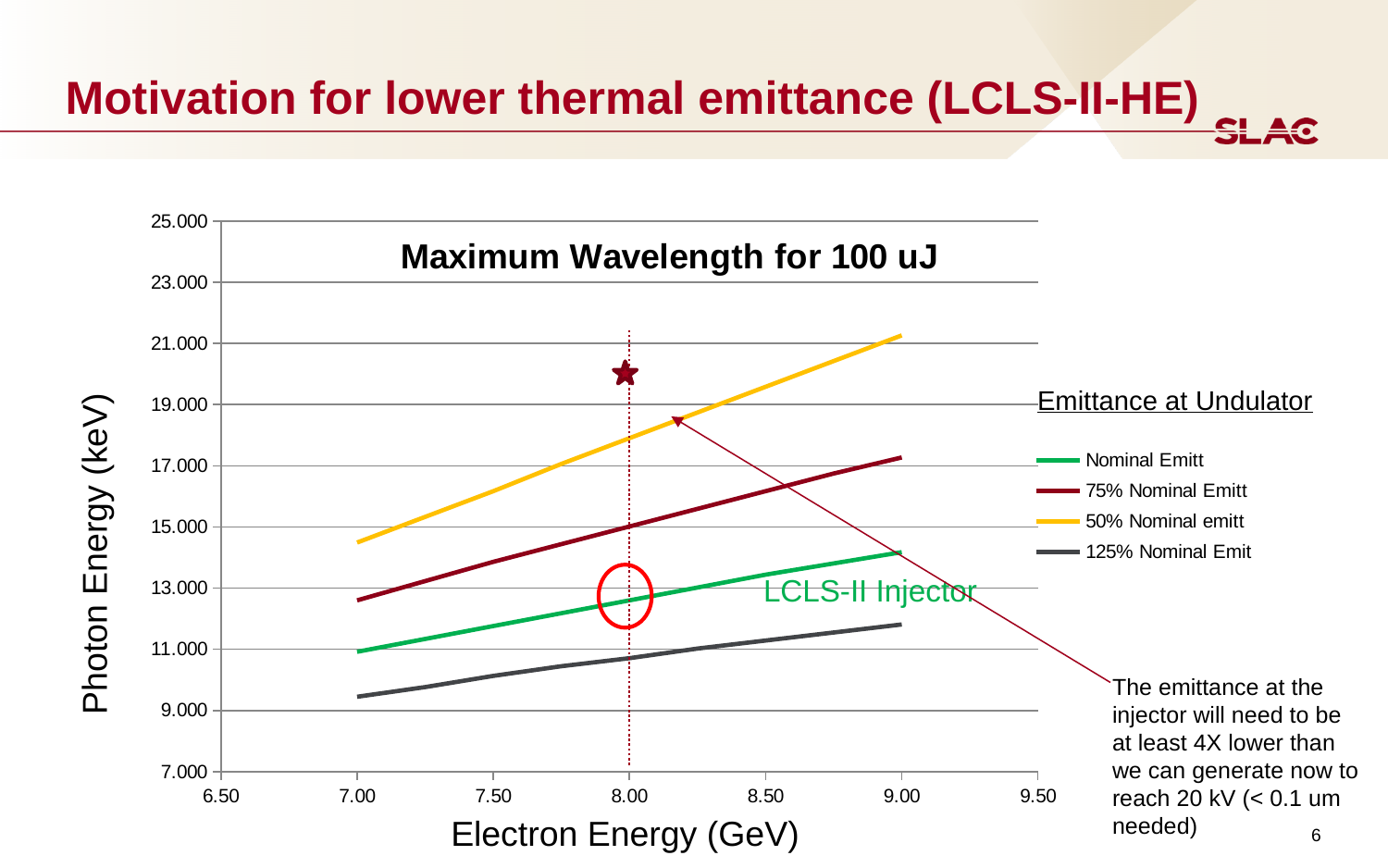
Do the values of the Nominal Emitt series rise or fall as electron energy increases from 7.00 to 9.00 GeV? rise What is the label of the y axis? Photon Energy (keV) Is the value for 75% Nominal Emitt at 9.00 GeV greater or less than 15.000? greater Which series has the highest photon energy at an electron energy of 9.00 GeV? 50% Nominal emitt Is the value for Nominal Emitt at 7.00 GeV greater or less than 13.000? less Is the value for 125% Nominal Emit at 7.00 GeV greater or less than 11.000? less At 8.00 GeV, which series has the larger photon energy: 75% Nominal Emitt or Nominal Emitt? 75% Nominal Emitt How many series does the legend list? 4 What kind of chart is shown on the slide? line chart What is the title of the chart? Maximum Wavelength for 100 uJ Which series has the lowest photon energy at an electron energy of 7.00 GeV? 125% Nominal Emit